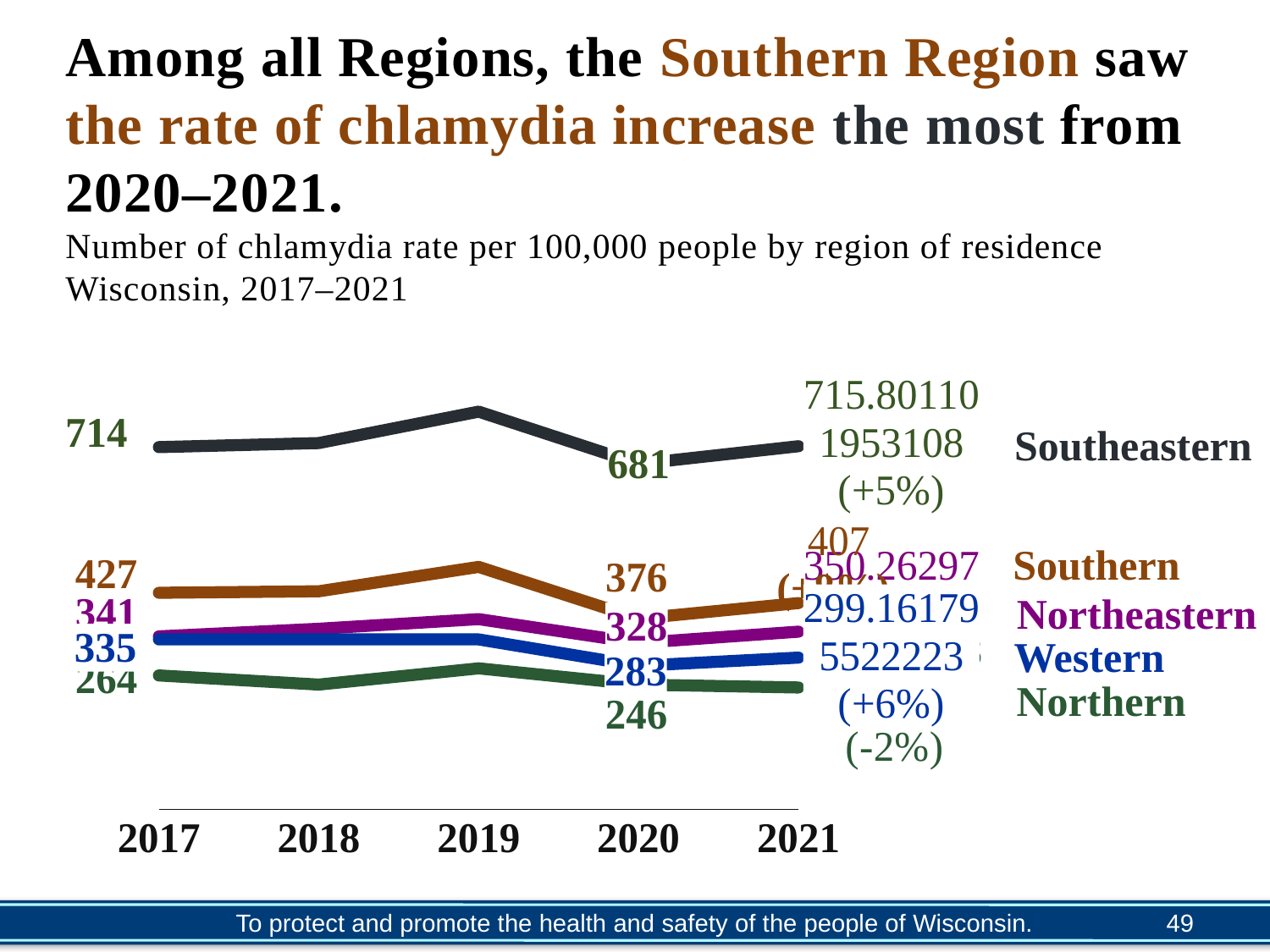
What was the chlamydia rate for the Western region in 2020? 283 What kind of chart is shown on the slide? line chart In 2020, which region had the higher rate: Southern or Northeastern? Southern Between 2019 and 2020, did the Southeastern region's line rise or fall? fall What was the chlamydia rate for the Northern region in 2017? 264 By how much did the Southeastern region's rate change from 2017 (714) to 2020 (681)? 33 What was the chlamydia rate for the Southeastern region in 2017? 714 Which region had the lowest chlamydia rate in 2020? Northern How many regions (series) are plotted on the chart? 5 Which region had the highest chlamydia rate in 2017? Southeastern How many years are shown along the x axis of the chart? 5 What was the chlamydia rate for the Southern region in 2020? 376